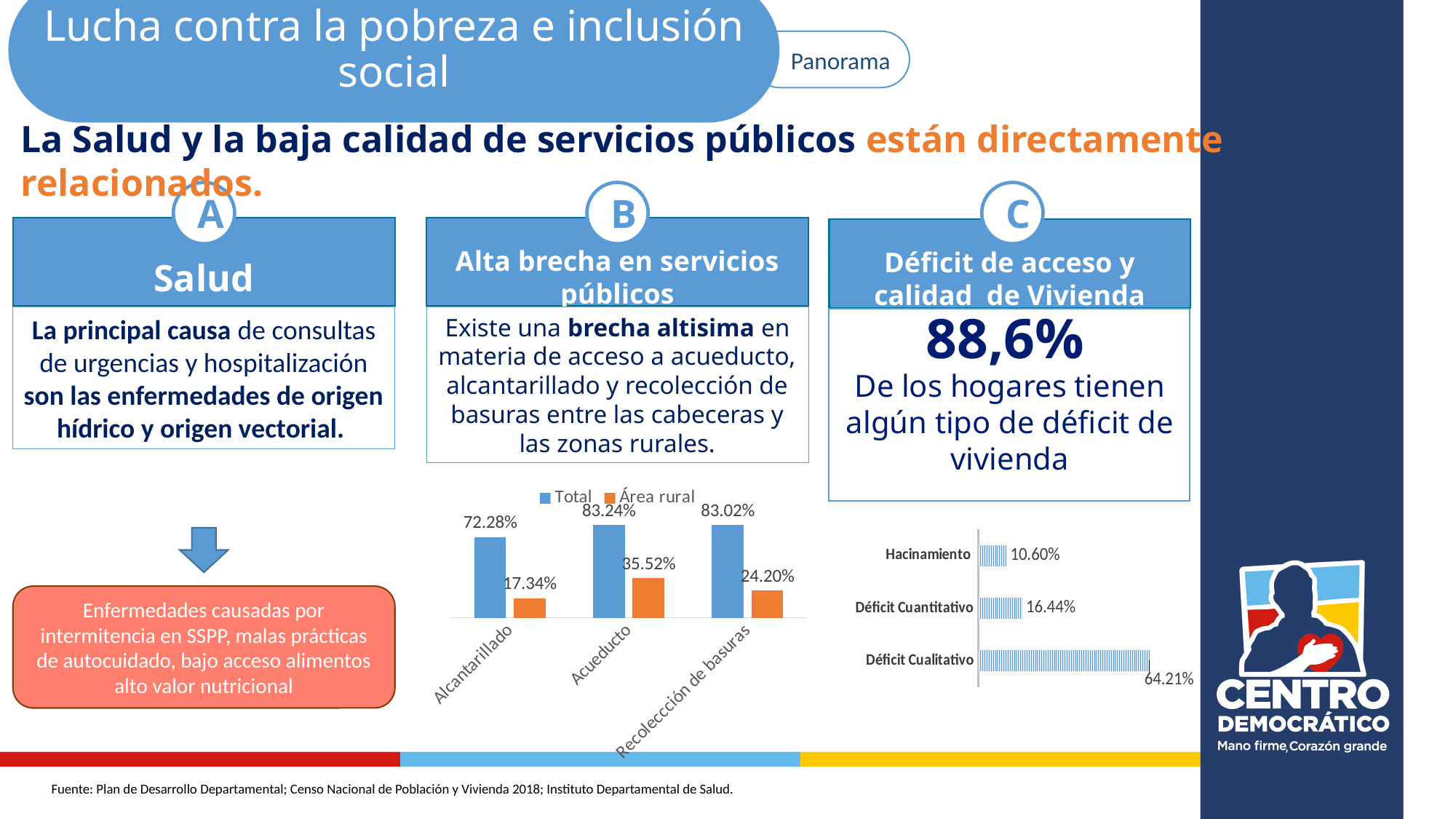
In the bar chart in the middle of the slide, how many series does the legend list? 2 In the bar chart in the middle of the slide, what is the Área rural value for Recolección de basuras? 24.20% In the bar chart in the middle of the slide, which category has the lowest Área rural value? Alcantarillado In the bar chart in the middle of the slide, what is the Total value for Alcantarillado? 72.28% In the bar chart in the middle of the slide, what is the Área rural value for Acueducto? 35.52% In the bar chart in the middle of the slide, how many categories are shown on the x axis? 3 In the horizontal bar chart on the right of the slide, what is the value for Déficit Cualitativo? 64.21% In the horizontal bar chart on the right of the slide, what is the value for Hacinamiento? 10.60% In the horizontal bar chart on the right of the slide, which category has the highest value? Déficit Cualitativo In the bar chart in the middle of the slide, which category has the highest Total value? Acueducto In the horizontal bar chart on the right of the slide, what is the difference between Déficit Cuantitativo and Hacinamiento? 5.84% In the bar chart in the middle of the slide, what is the difference between the Total and Área rural values for Alcantarillado? 54.94%